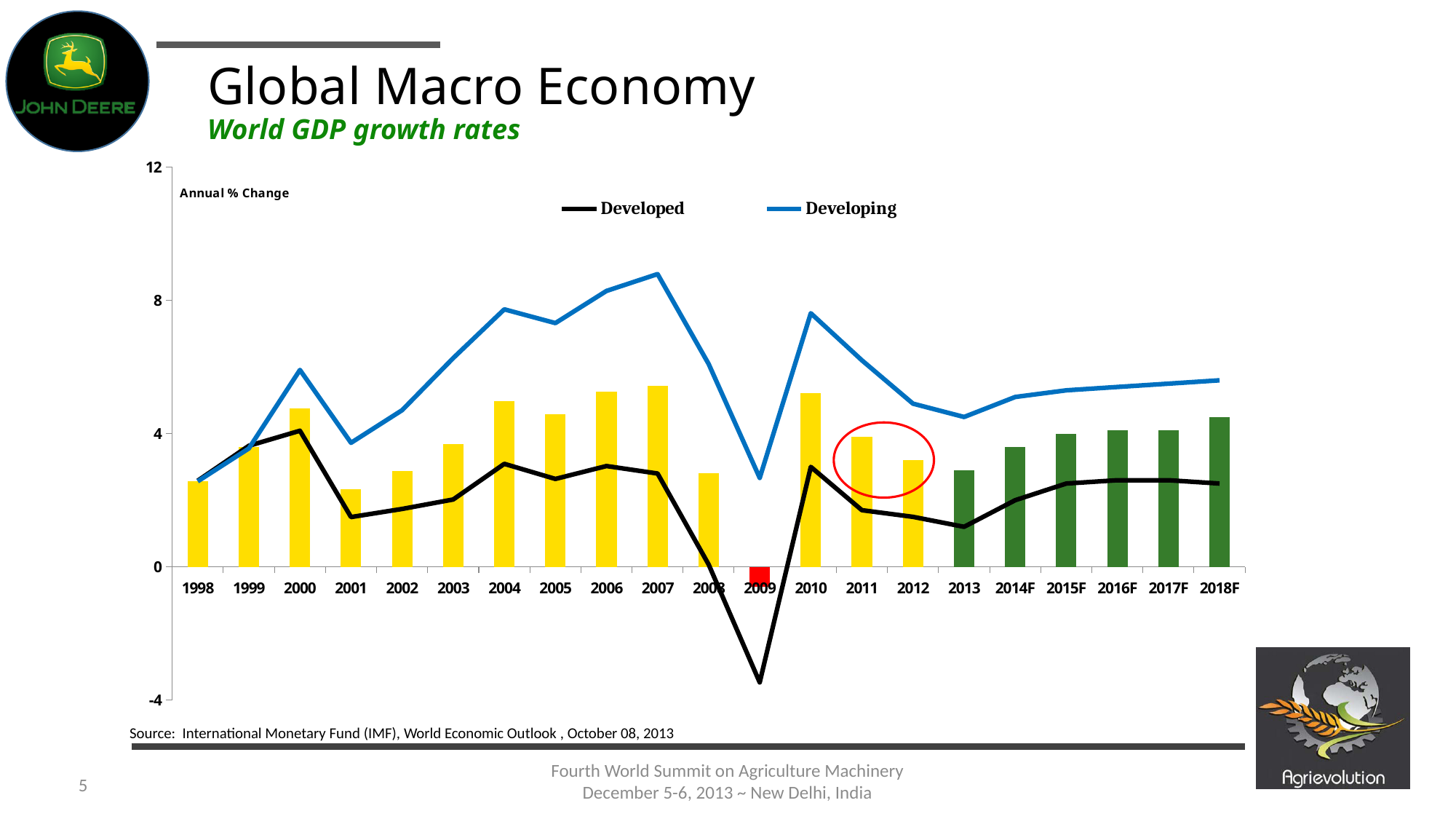
What kind of chart is shown on the slide? Combined bar and line chart How many series does the chart legend list? 2 What label is shown for the y axis of the chart? Annual % Change Is the value of the Developing line in 2009 greater or less than 4? less What are the names of the two series in the legend? Developed and Developing In which year does the Developing line reach its highest value? 2007 In 2007, which series has the larger value, Developed or Developing? Developing How many years (categories) are shown on the x axis? 21 Does the Developing line rise or fall from 2009 to 2010? rise Is the value of the Developing line in 2007 greater or less than 8? greater In which year does the Developed line reach its lowest value? 2009 Is the value of the Developed line in 2009 greater or less than 0? less